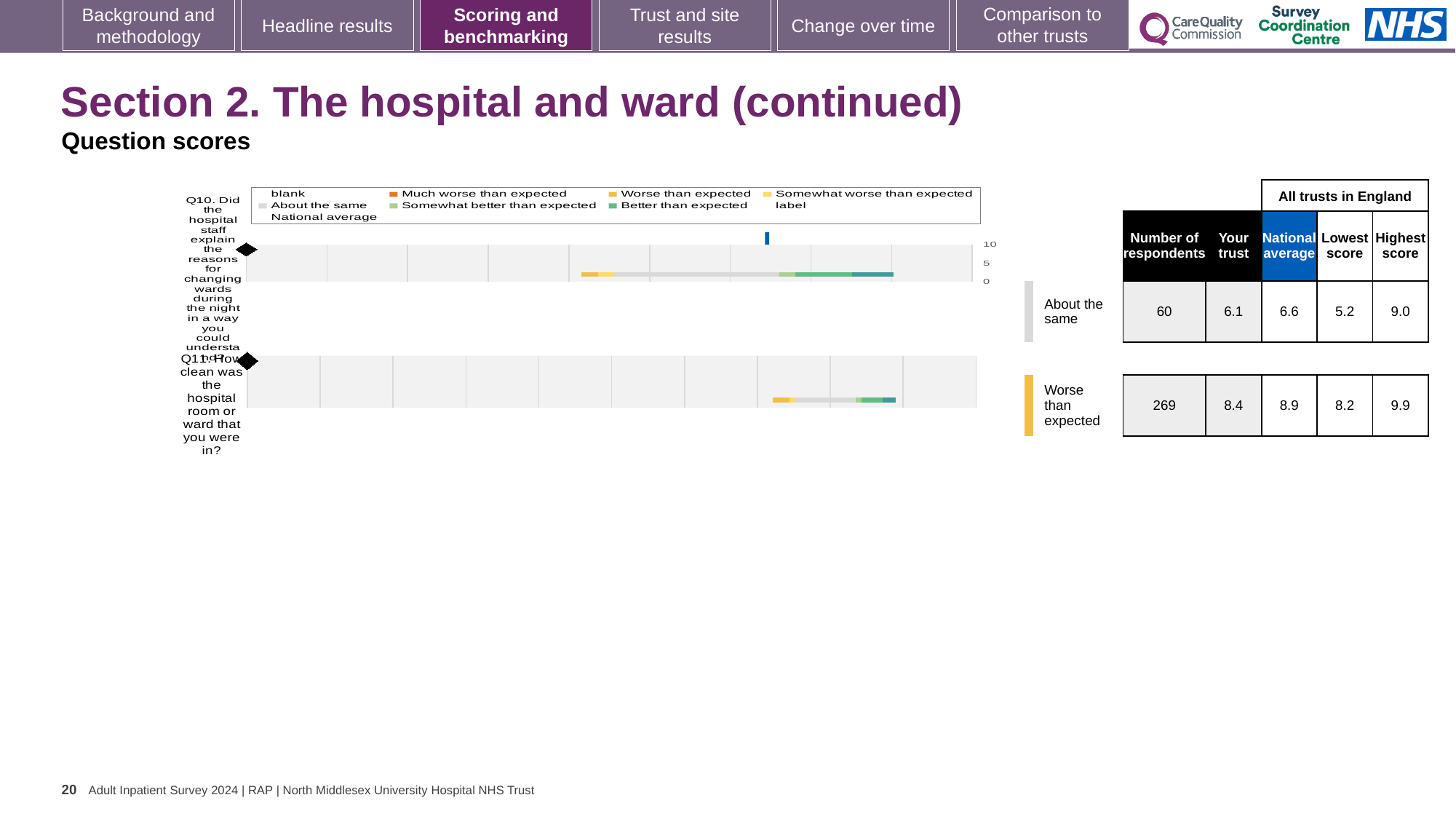
Which benchmark category is shown for Q11? Worse than expected What is the lowest score among all trusts in England for Q11? 8.2 What is the highest score among all trusts in England for Q10? 9.0 What is the 'Your trust' score for Q10 (explaining reasons for changing wards during the night)? 6.1 How many respondents answered Q11? 269 How many questions (rows) are plotted in the question scores chart? 2 By how much does the national average exceed the trust's score for Q10? 0.5 What is the national average score for Q11 (how clean was the hospital room or ward)? 8.9 Which question has the higher 'Your trust' score, Q10 or Q11? Q11 What kind of chart is used to show the question scores for Q10 and Q11? bar chart What is the difference between the highest and lowest scores for Q11? 1.7 For Q11, which is larger: the trust's score or the national average? National average